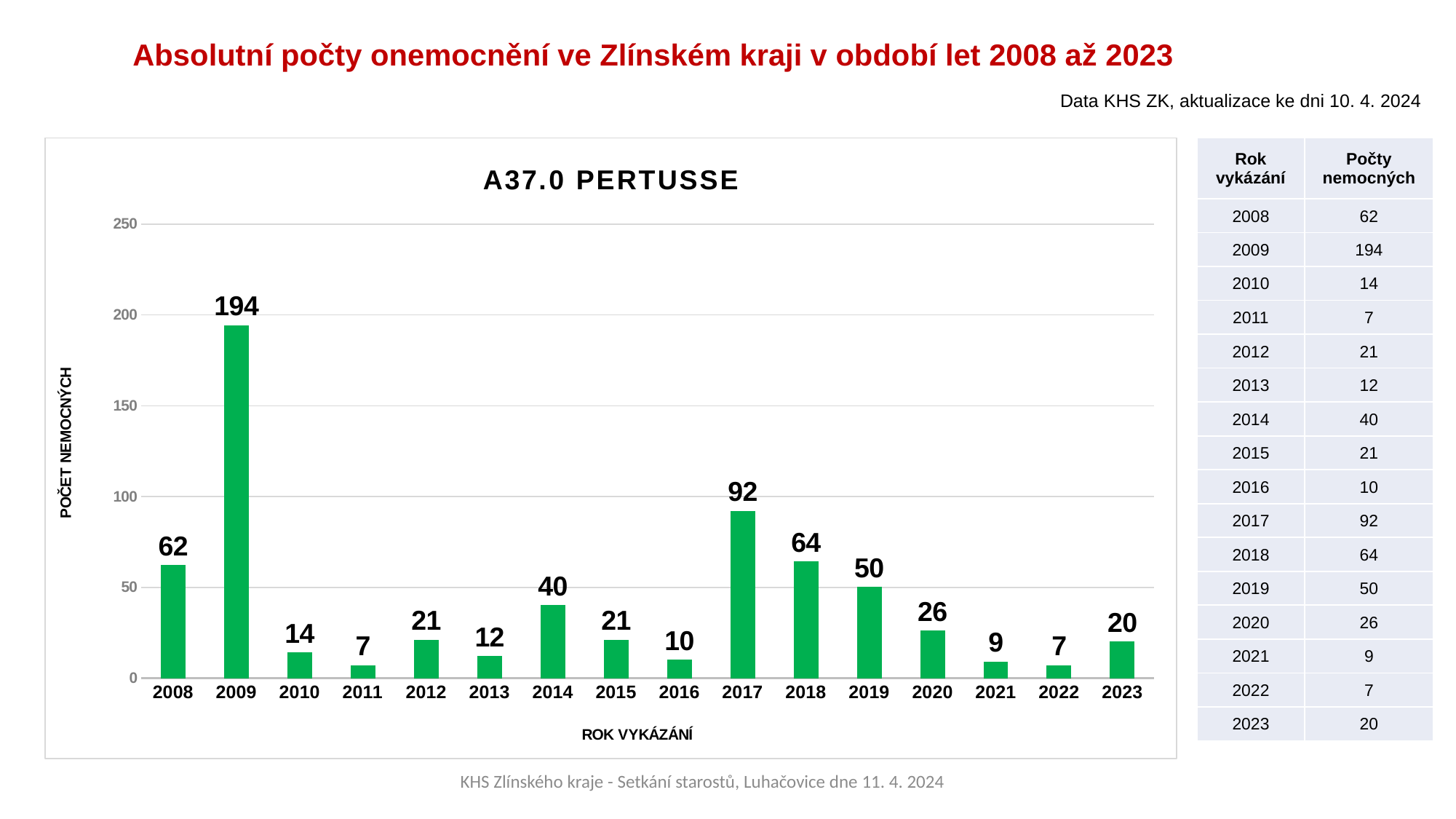
Do the values in the A37.0 PERTUSSE chart rise or fall from 2017 to 2022? fall What kind of chart is the A37.0 PERTUSSE chart? bar chart What is the title of the chart on the slide? A37.0 PERTUSSE Which is larger in the A37.0 PERTUSSE chart, the value for 2008 or the value for 2019? 2008 What is the value for 2017 in the A37.0 PERTUSSE chart? 92 How many years are shown on the x axis of the A37.0 PERTUSSE chart? 16 Which year has the highest value in the A37.0 PERTUSSE chart? 2009 What is the label of the y axis in the A37.0 PERTUSSE chart? POČET NEMOCNÝCH What is the difference between the values for 2017 and 2018 in the A37.0 PERTUSSE chart? 28 What is the value for 2009 in the A37.0 PERTUSSE chart? 194 Is the value for 2014 in the A37.0 PERTUSSE chart greater or less than 50? less What is the value for 2023 in the A37.0 PERTUSSE chart? 20